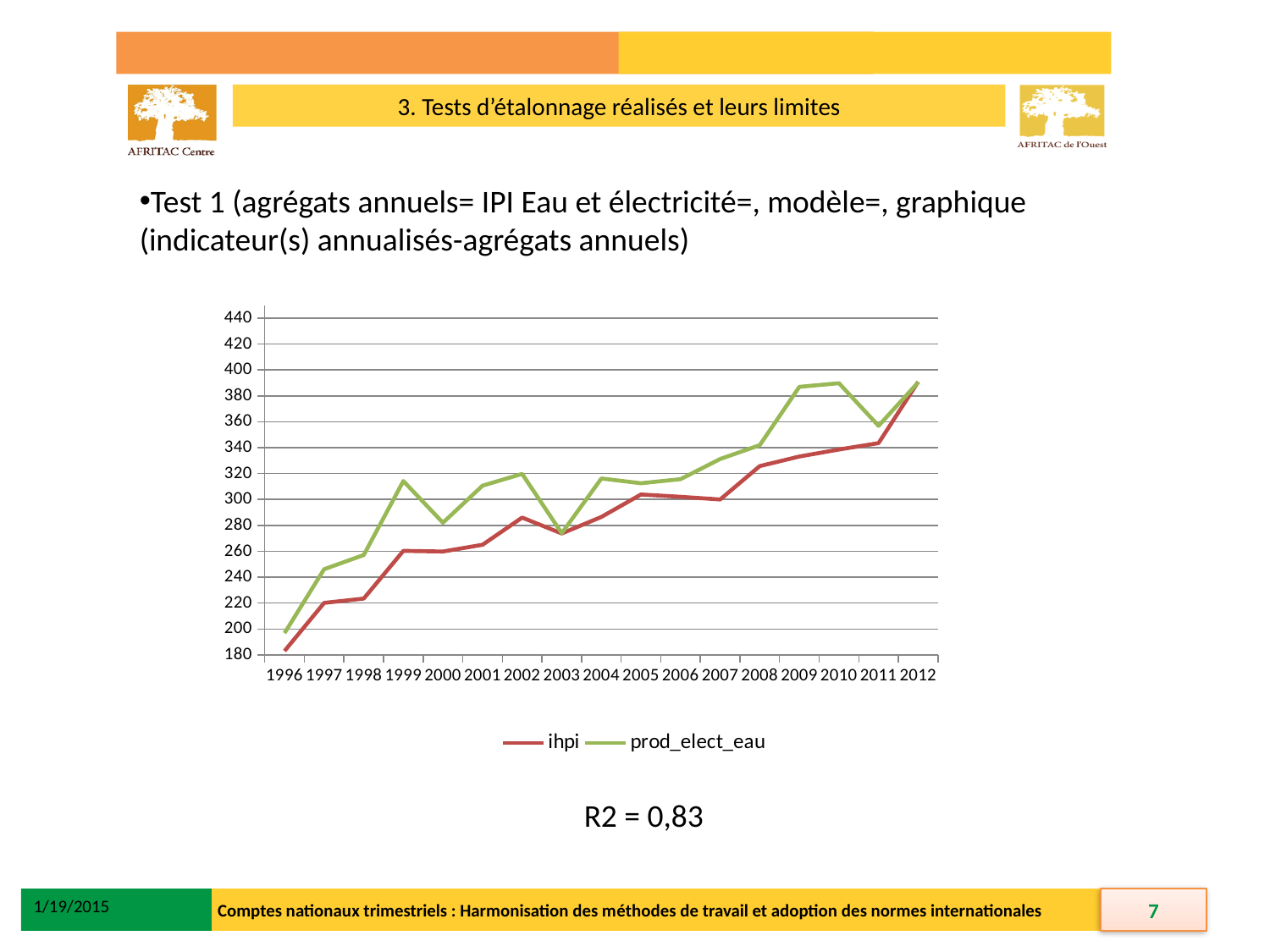
What kind of chart is shown on the slide? line chart Does the ihpi series generally rise or fall from 1996 to 2012? rise Is the value of prod_elect_eau in 2000 greater or less than 300? less How many years are plotted along the x axis? 17 In 2009, which series has the higher value, ihpi or prod_elect_eau? prod_elect_eau What is the R2 value stated below the chart? 0,83 In which year is the ihpi series at its highest? 2012 Which series is drawn in red? ihpi Is the value of ihpi in 1996 greater or less than 200? less Is the value of prod_elect_eau in 2009 greater or less than 360? greater In which year is the ihpi series at its lowest? 1996 How many series does the legend list? 2